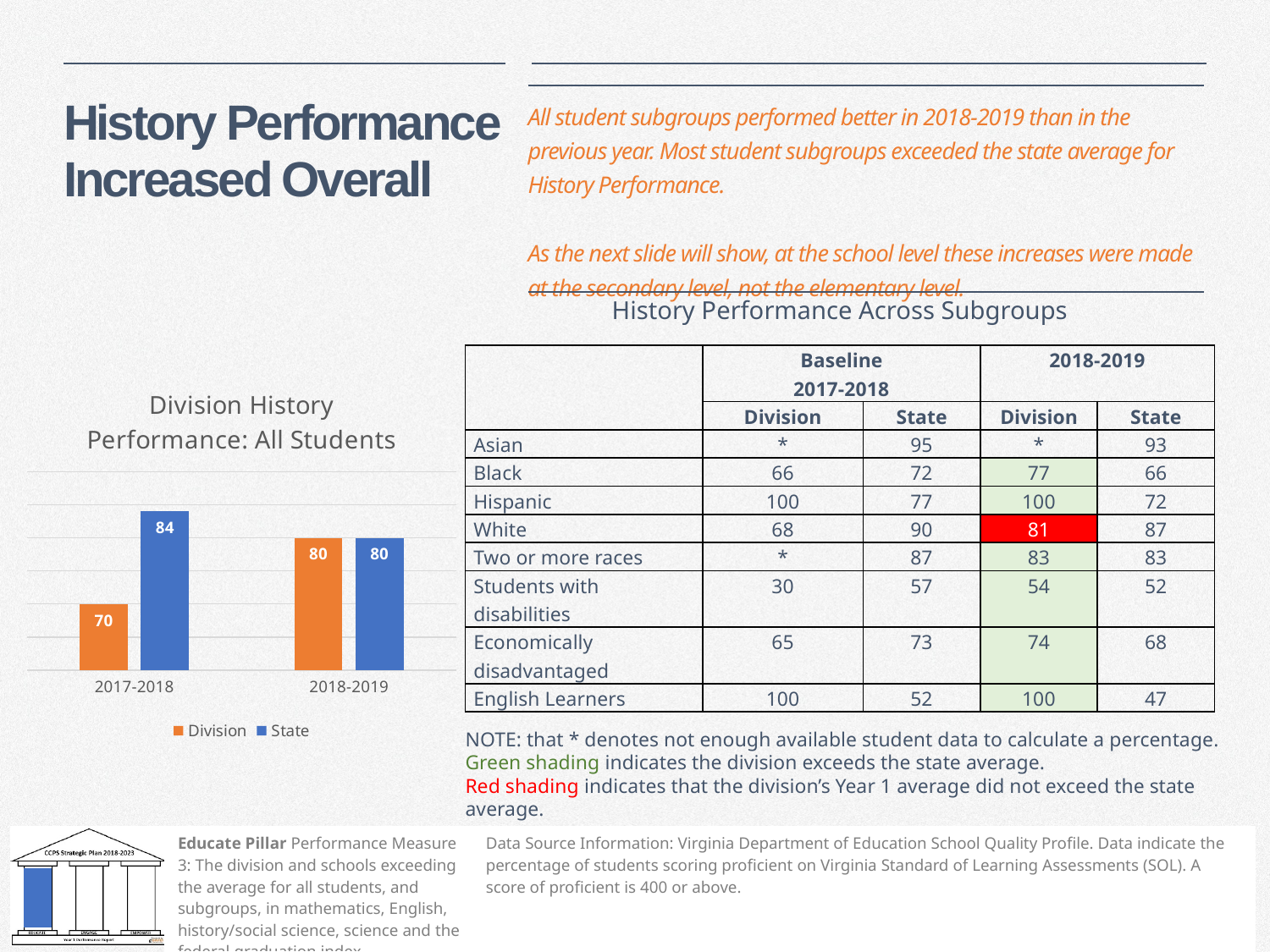
In the Division History Performance: All Students chart, does the Division value rise or fall from 2017-2018 to 2018-2019? rise In the Division History Performance: All Students chart, by how much did the Division value increase from 2017-2018 to 2018-2019? 10 What is the State value for 2017-2018 in the Division History Performance: All Students chart? 84 In the Division History Performance: All Students chart, what is the difference between the State and Division values for 2017-2018? 14 In the Division History Performance: All Students chart, which year has the higher State value? 2017-2018 What is the Division value for 2017-2018 in the Division History Performance: All Students chart? 70 How many series does the legend of the Division History Performance: All Students chart list? 2 In the Division History Performance: All Students chart, which year has the lower Division value? 2017-2018 What is the State value for 2018-2019 in the Division History Performance: All Students chart? 80 What type of chart is the Division History Performance: All Students chart? bar chart In the Division History Performance: All Students chart, is the Division value for 2017-2018 larger or smaller than the State value for 2017-2018? smaller What is the Division value for 2018-2019 in the Division History Performance: All Students chart? 80